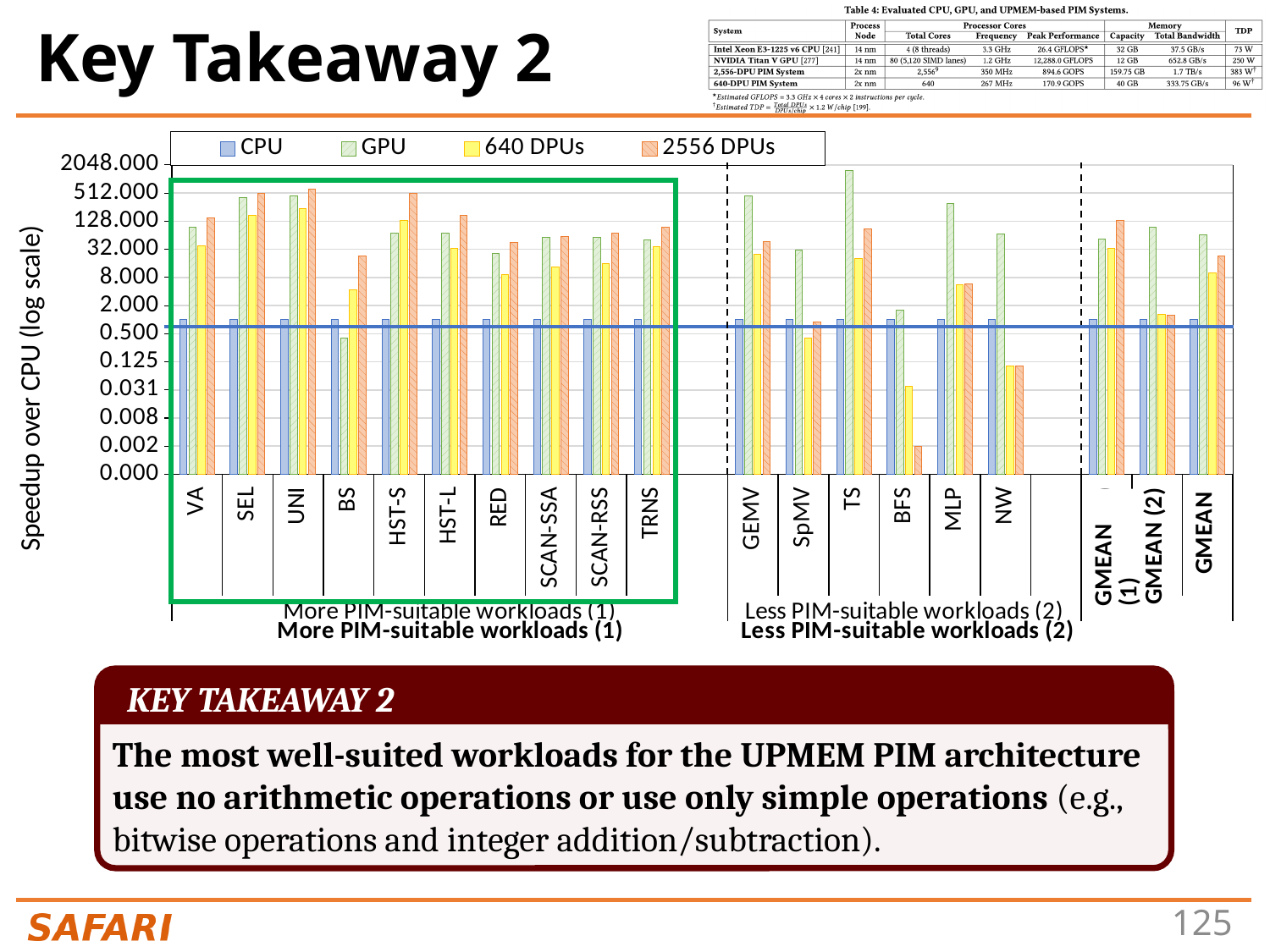
Which workload has the lowest 2556 DPUs bar in the chart? BFS For BS, which is larger: the 640 DPUs value or the 2556 DPUs value? 2556 DPUs Which series are listed in the chart legend? CPU, GPU, 640 DPUs, 2556 DPUs What kind of chart is shown on the slide? bar chart Is the 2556 DPUs value for SEL greater or less than 128.000? greater What is the label of the y axis of the chart? Speedup over CPU (log scale) For TS, which is larger: the GPU value or the 640 DPUs value? GPU Is the GPU value for TS greater or less than 512.000? greater Is the 640 DPUs value for NW greater or less than 0.500? less How many series does the chart legend list? 4 Which workload has the highest GPU bar in the chart? TS